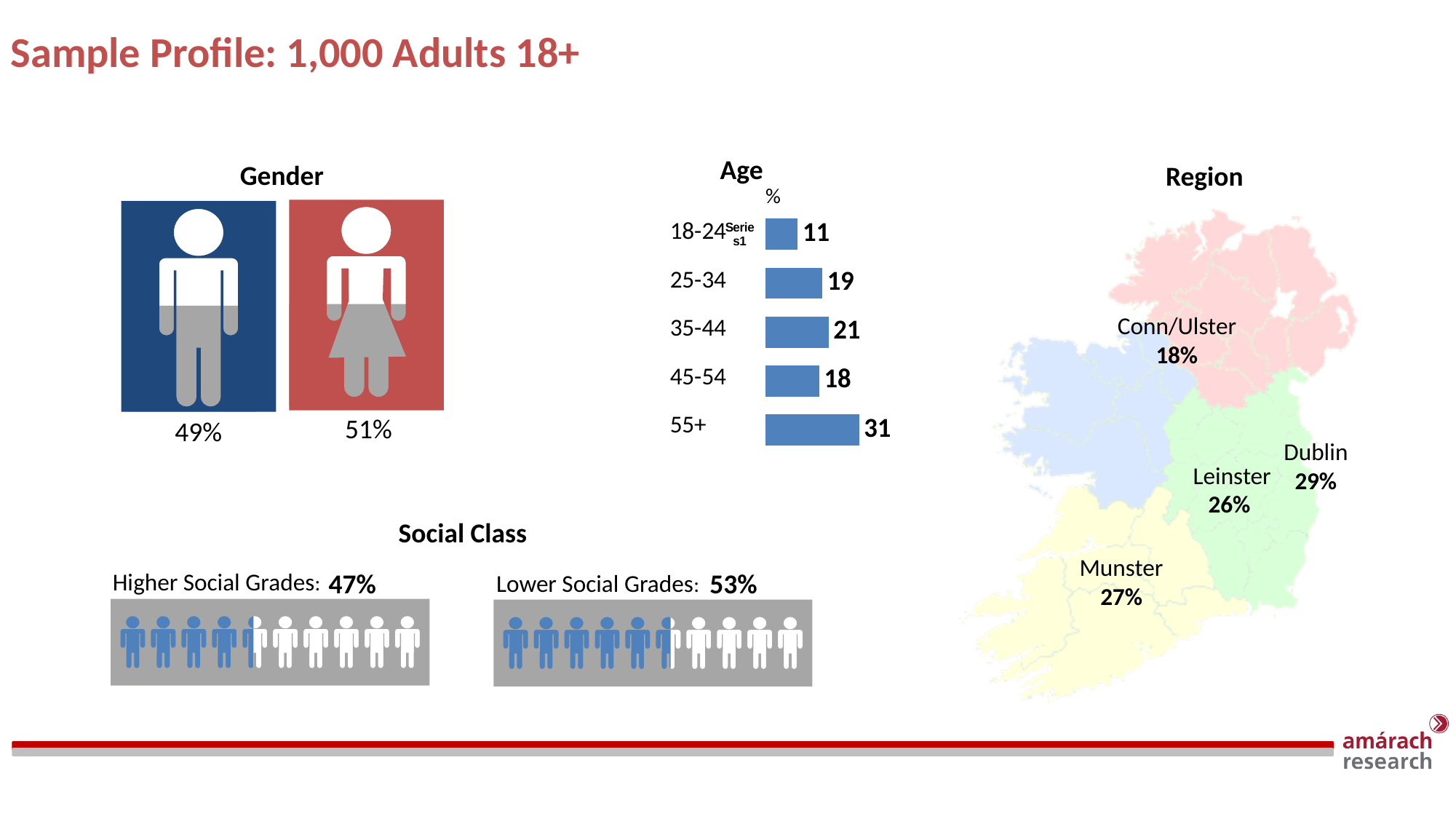
In the Age chart, what is the value for the 55+ age group? 31 What unit label is shown above the bars in the Age chart? % In the Age chart, which age group has the highest value? 55+ In the Age chart, what is the value for the 35-44 age group? 21 In the Age chart, what is the value for the 45-54 age group? 18 What kind of chart is the Age chart? bar chart In the Age chart, what is the difference between the values for 55+ and 18-24? 20 In the Age chart, what is the difference between the values for 35-44 and 25-34? 2 In the Age chart, which age group has the lowest value? 18-24 In the Age chart, what is the value for the 18-24 age group? 11 In the Age chart, which has the larger value, 25-34 or 45-54? 25-34 How many age groups are shown in the Age chart? 5